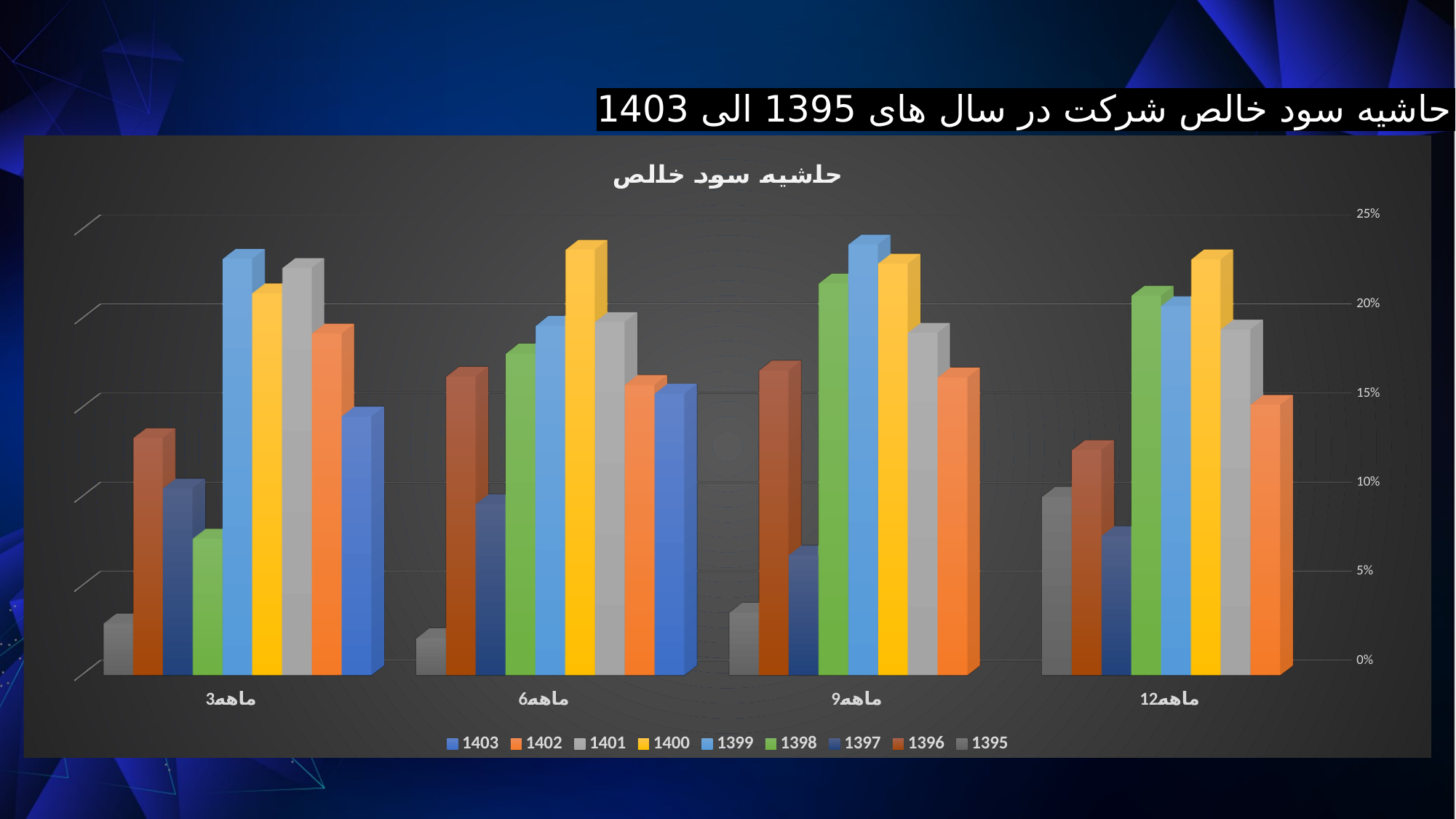
Is the value for 1399 in the 3 ماهه group greater or less than 20%? greater Is the value for 1395 in the 3 ماهه group greater or less than 5%? less How many categories are shown on the x axis? 4 Which series has the highest value in the 12 ماهه group? 1400 What kind of chart is shown on the slide? bar chart Which series has the highest value in the 6 ماهه group? 1400 How many series does the legend list? 9 In the 12 ماهه group, which is larger, the value for 1398 or the value for 1402? 1398 What is the title of the chart? حاشیه سود خالص Is the value for 1400 in the 6 ماهه group greater or less than 20%? greater Which series has the lowest value in the 9 ماهه group? 1395